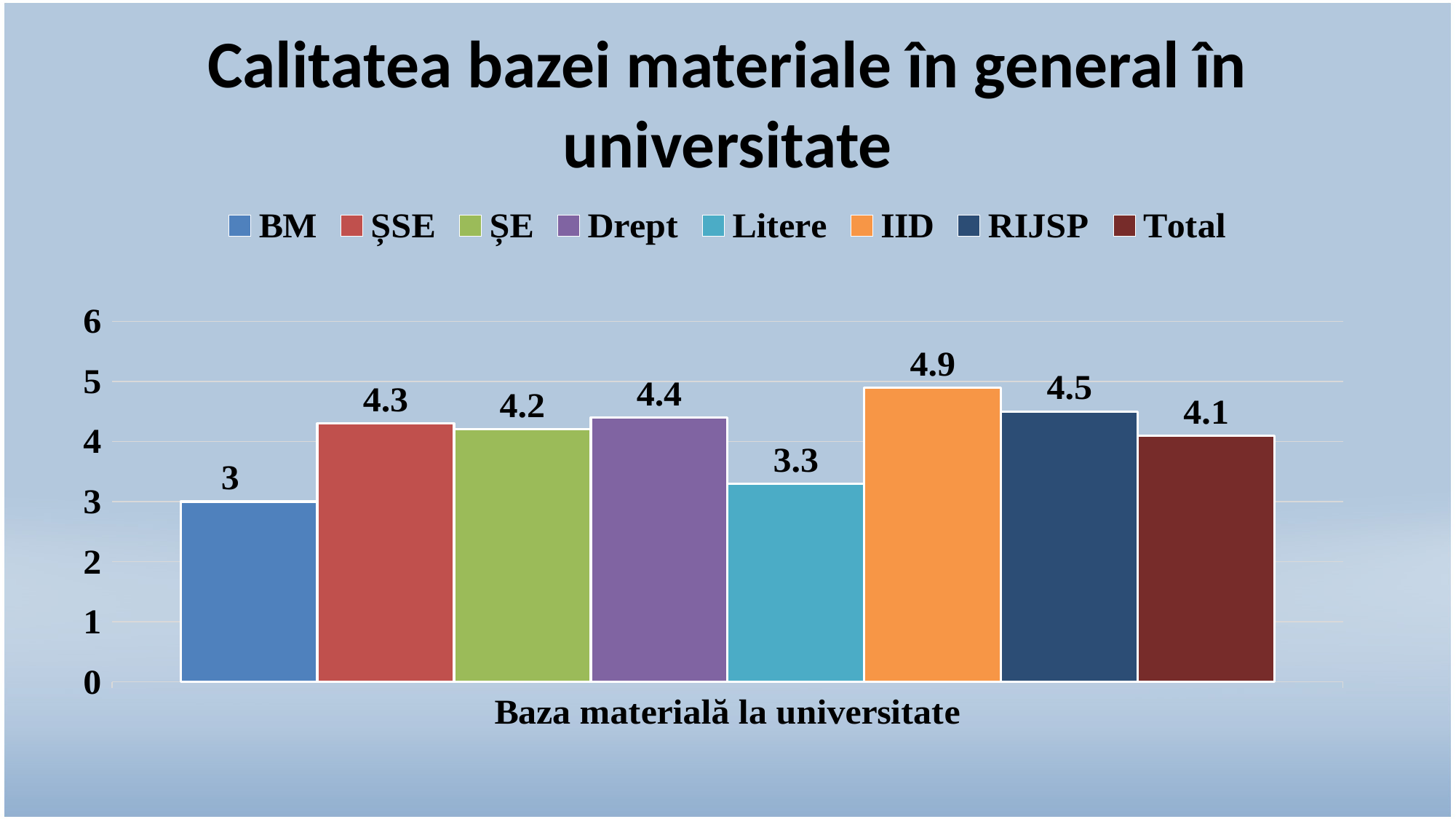
What is the title of the chart? Calitatea bazei materiale în general în universitate Which is larger, the value for Drept or the value for ȘE? Drept What is the value for Total? 4.1 Which series has the highest value? IID What is the value for Litere? 3.3 What is the value for IID? 4.9 What is the difference between the values for RIJSP and Litere? 1.2 Which series has the lowest value? BM What is the difference between the values for IID and BM? 1.9 What kind of chart is shown on the slide? Bar chart What is the value for BM? 3 How many series does the legend list? 8